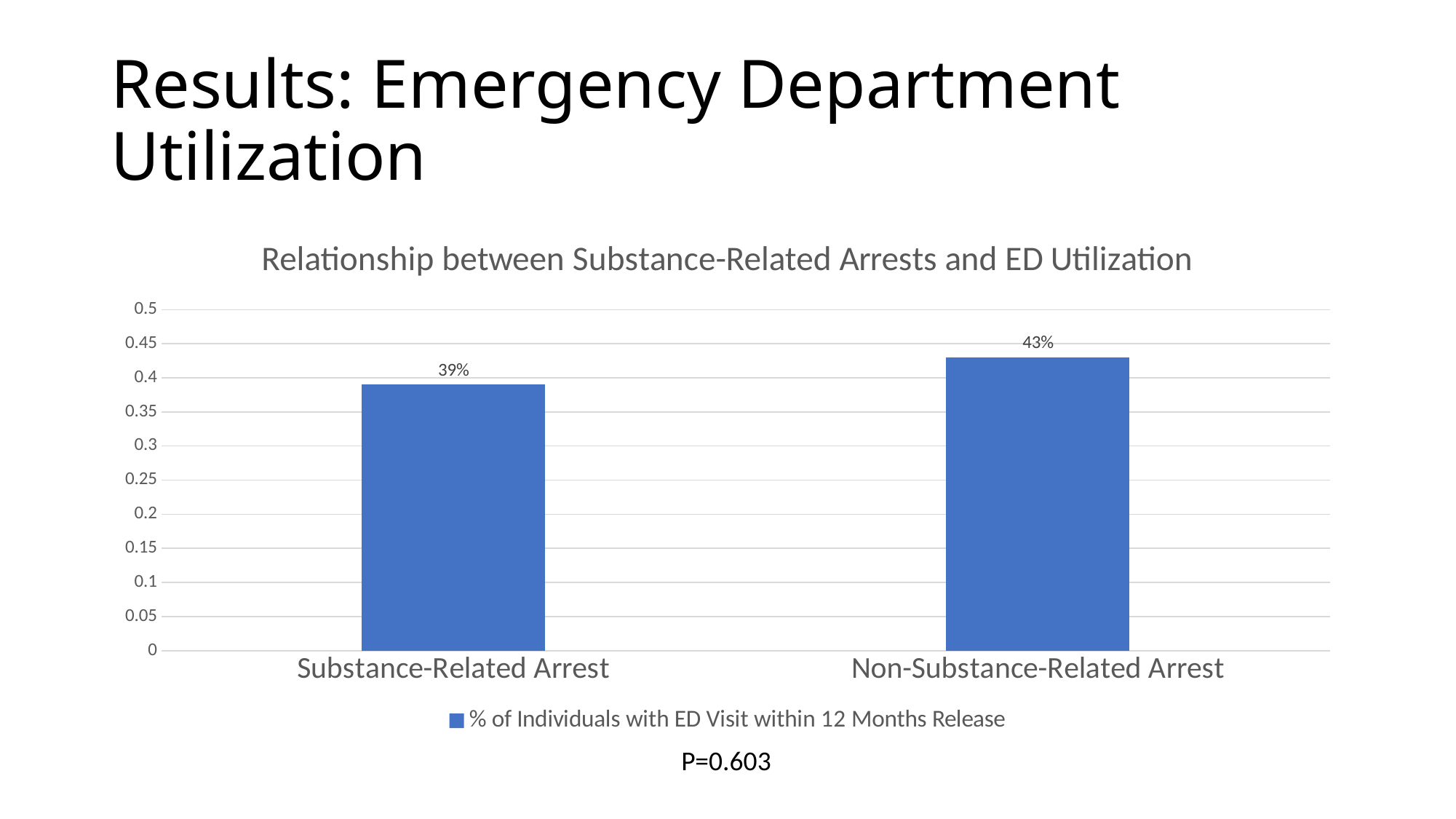
Is the value for Non-Substance-Related Arrest greater or less than 0.4? greater How many series does the legend list? 1 What is the difference between the values for Non-Substance-Related Arrest and Substance-Related Arrest? 4% What is the title of the chart? Relationship between Substance-Related Arrests and ED Utilization Which category has the highest value? Non-Substance-Related Arrest What is the value for Substance-Related Arrest? 39% What kind of chart is shown on the slide? Bar chart Which category has the lowest value? Substance-Related Arrest Which is larger, the value for Substance-Related Arrest or the value for Non-Substance-Related Arrest? Non-Substance-Related Arrest What is the value for Non-Substance-Related Arrest? 43% How many categories are shown on the chart? 2 Is the value for Substance-Related Arrest greater or less than 0.4? less